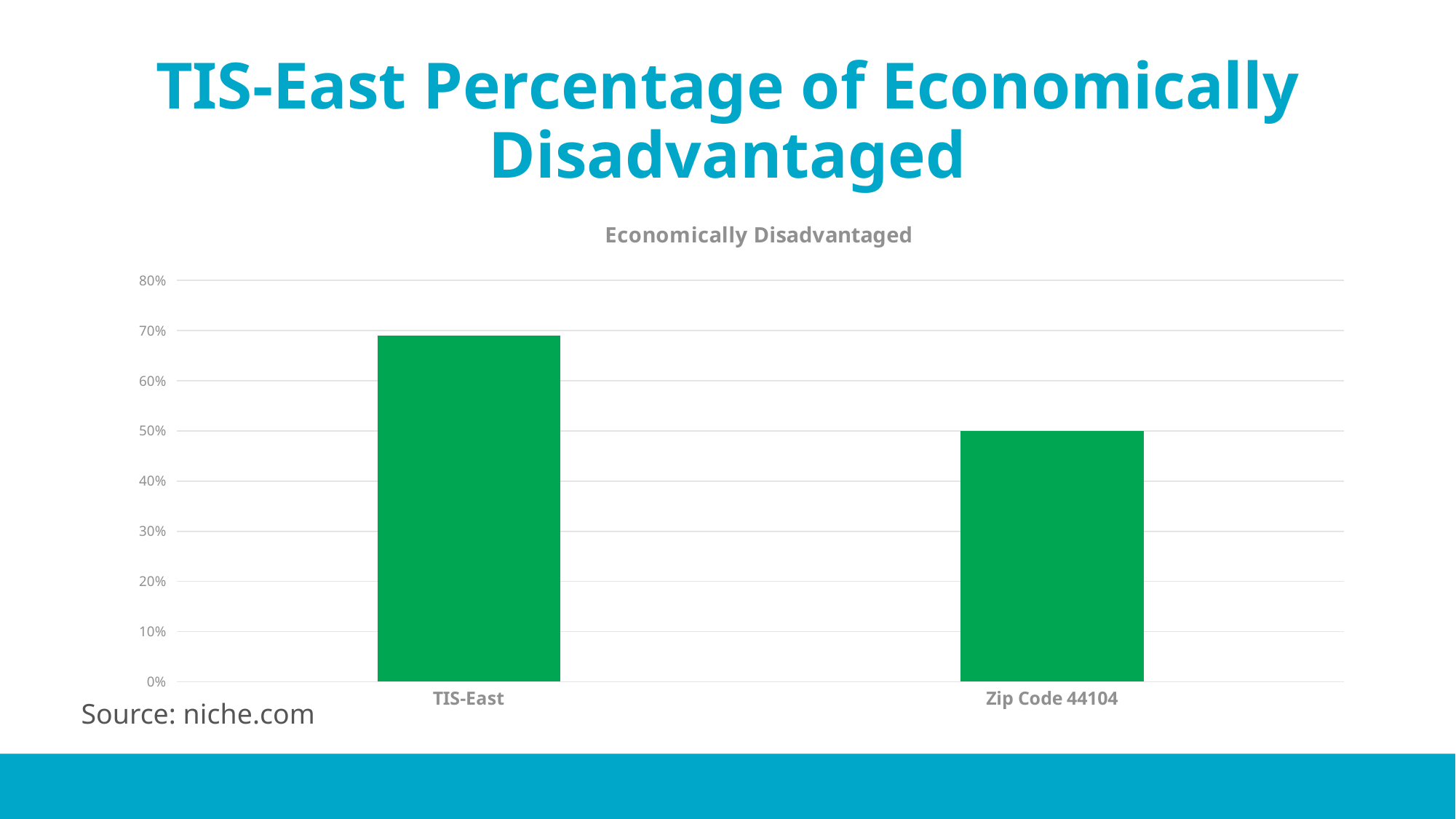
What type of chart is shown on the slide? bar chart Is the value for TIS-East greater or less than 80%? less What is the title shown directly above the chart's plot area? Economically Disadvantaged Is the value for Zip Code 44104 greater or less than 60%? less Which category has the highest value in the chart? TIS-East What source is cited for the chart data? niche.com What is the value for Zip Code 44104? 50% Is the value for Zip Code 44104 greater or less than 40%? greater Which category has the lowest value in the chart? Zip Code 44104 How many categories are plotted in the chart? 2 Which is larger, the value for TIS-East or the value for Zip Code 44104? TIS-East